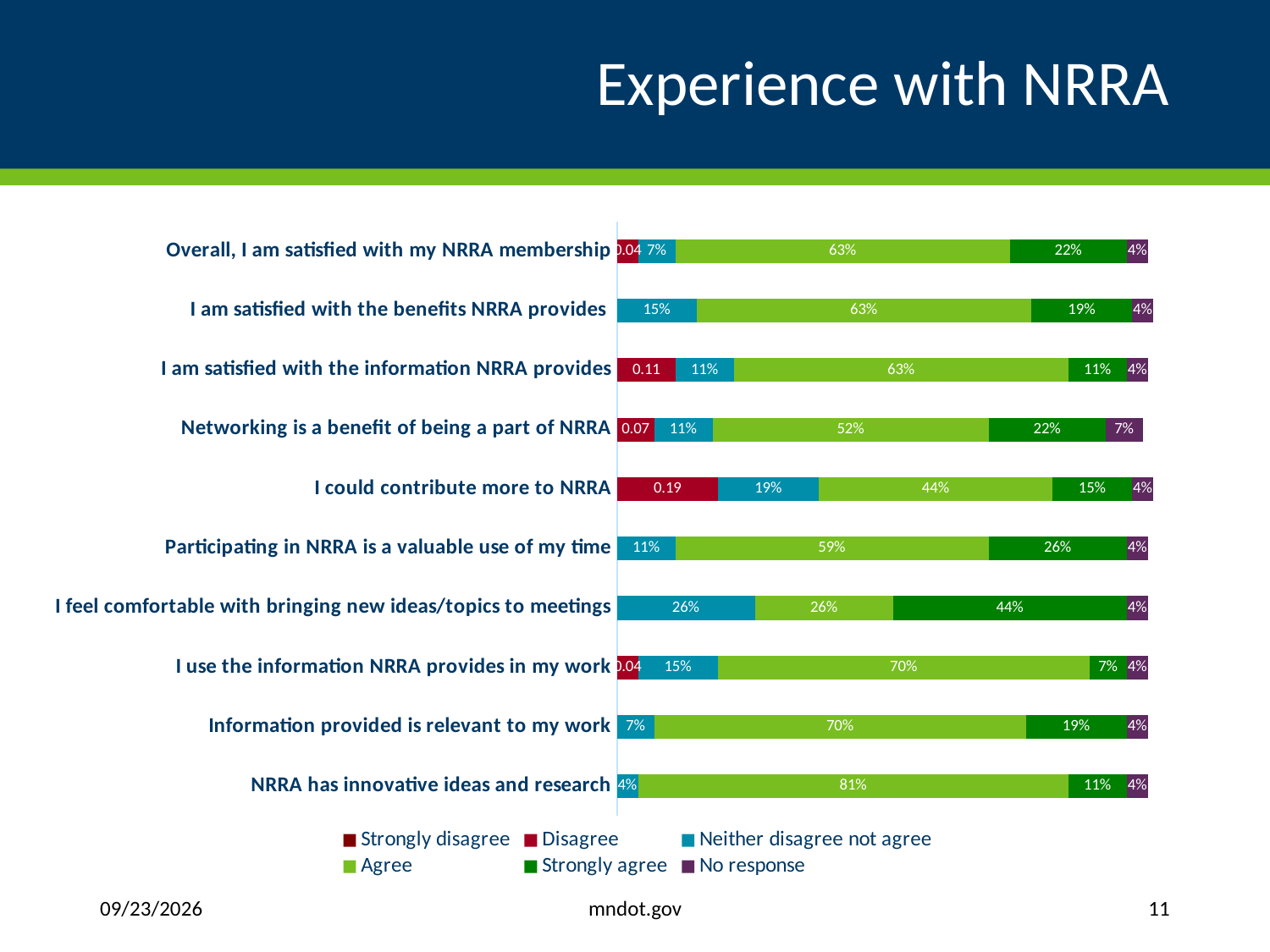
How many series does the legend list? 6 What is the difference between the Agree values for "I use the information NRRA provides in my work" and "Networking is a benefit of being a part of NRRA"? 18% What is the title of the slide containing the chart? Experience with NRRA What is the Strongly agree value for "I feel comfortable with bringing new ideas/topics to meetings"? 44% What is the Agree value for "NRRA has innovative ideas and research"? 81% Which statement has the lowest Agree value? I feel comfortable with bringing new ideas/topics to meetings Which has a larger Strongly agree value: "Participating in NRRA is a valuable use of my time" or "I am satisfied with the benefits NRRA provides"? Participating in NRRA is a valuable use of my time Which statement has the highest Agree value? NRRA has innovative ideas and research What is the total of the labelled segments for "Information provided is relevant to my work"? 100% How many statements (categories) are plotted in the chart? 10 What is the Neither disagree not agree value for "I could contribute more to NRRA"? 19% What kind of chart is shown on the slide? Stacked bar chart